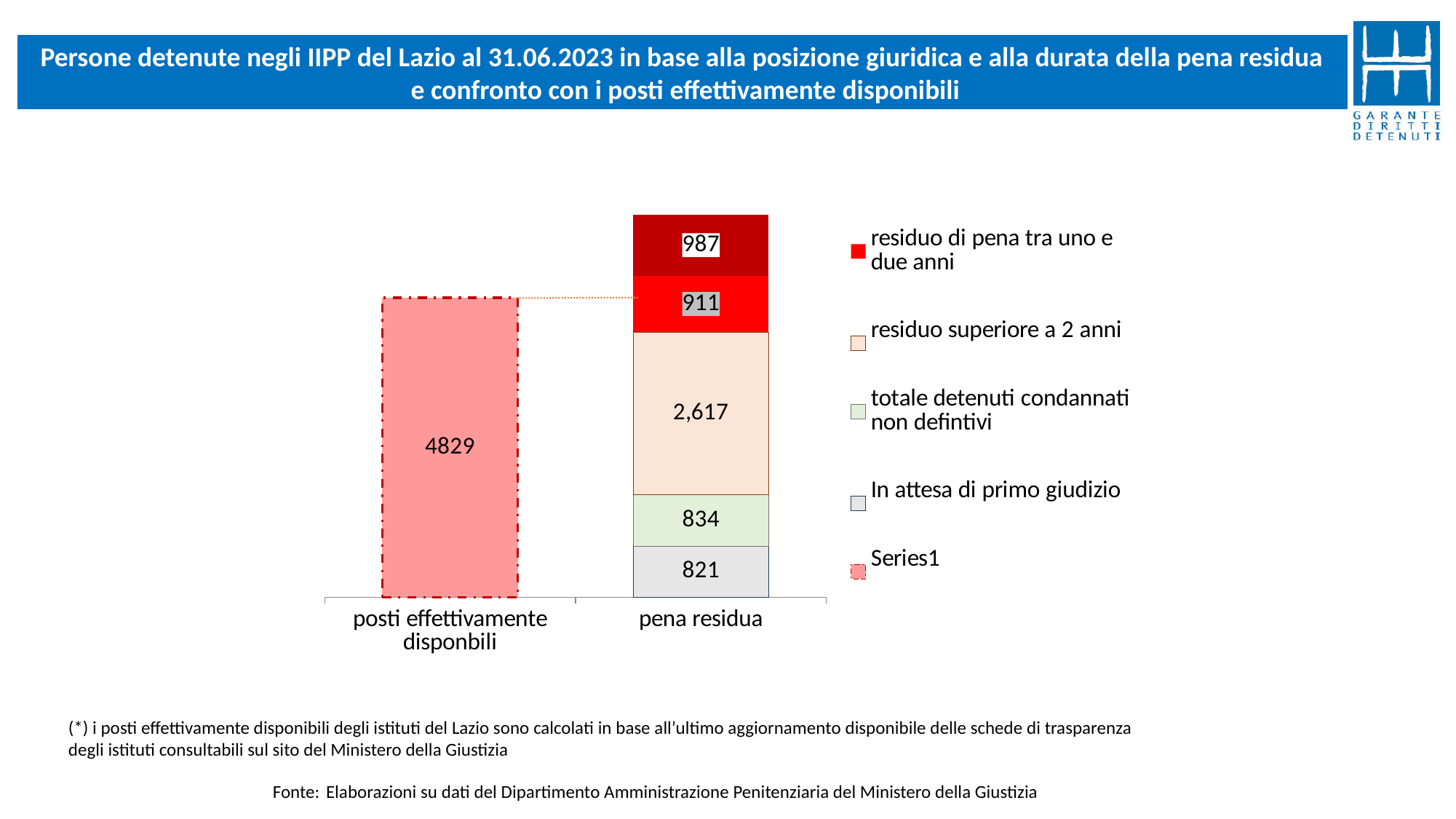
How many entries does the legend list? 5 What is the value shown for 'posti effettivamente disponibili'? 4829 Which segment of the 'pena residua' bar is the largest? residuo superiore a 2 anni In the 'pena residua' bar, what is the value for 'totale detenuti condannati non defintivi'? 834 How many categories are shown on the x axis? 2 In the 'pena residua' bar, what is the value for 'residuo di pena tra uno e due anni'? 911 What kind of chart is shown on the slide? bar chart In the 'pena residua' bar, what is the value for 'residuo superiore a 2 anni'? 2,617 What is the total of the stacked 'pena residua' bar? 6170 What is the value of the topmost segment of the 'pena residua' bar? 987 What is the difference between the 'residuo superiore a 2 anni' segment (2,617) and the 'In attesa di primo giudizio' segment (821)? 1796 In the 'pena residua' bar, what is the value for 'In attesa di primo giudizio'? 821